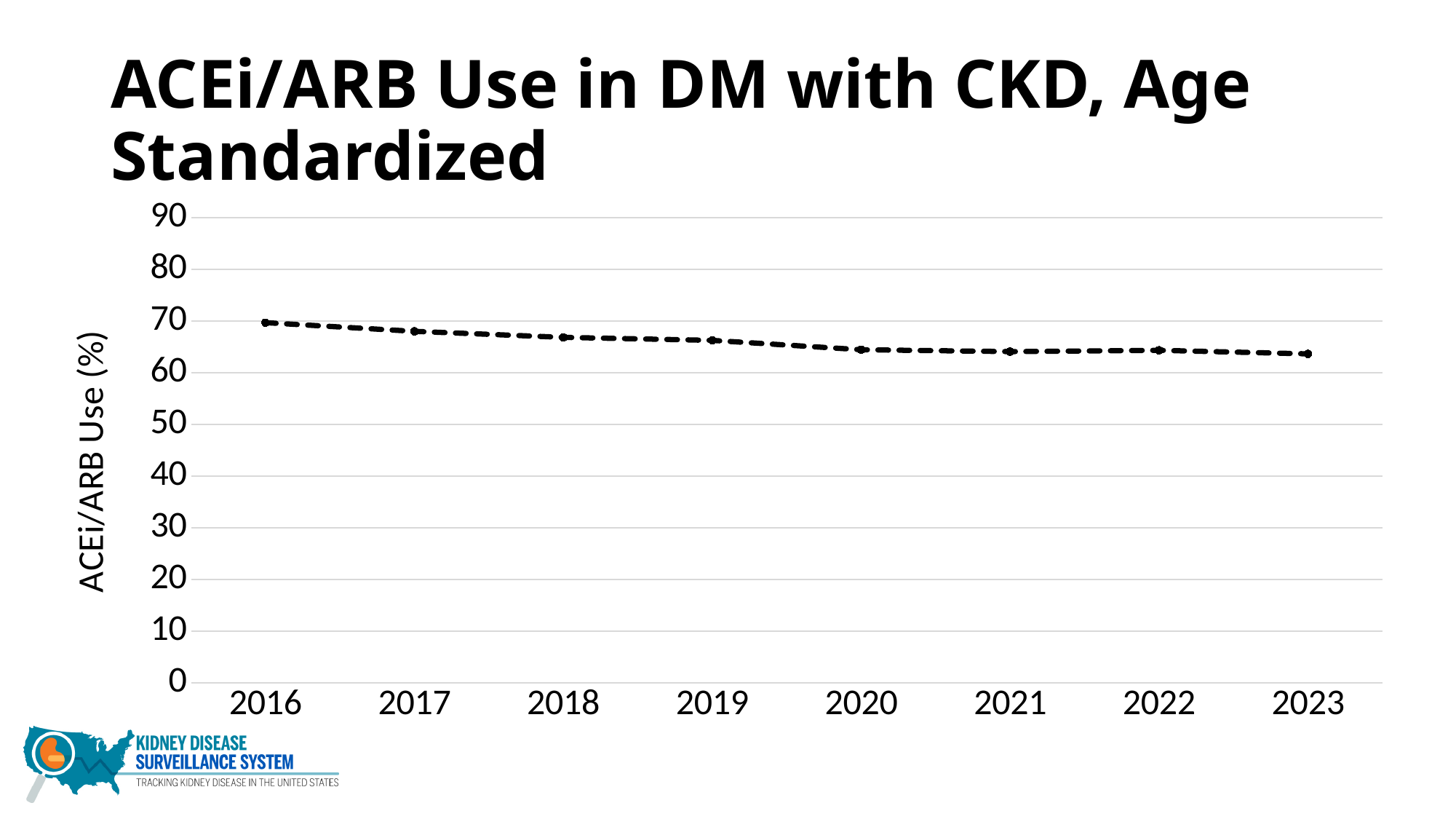
What is the title of the chart? ACEi/ARB Use in DM with CKD, Age Standardized What is the label on the y axis? ACEi/ARB Use (%) Do the values rise or fall from 2016 to 2023? fall Is the value for 2016 greater or less than 60? greater Which year has the highest ACEi/ARB use? 2016 Is the value for 2023 greater or less than 70? less What kind of chart is shown on the slide? line chart Is the value for 2016 greater or less than 80? less How many years are plotted along the x axis? 8 Which is larger, the value for 2016 or the value for 2023? 2016